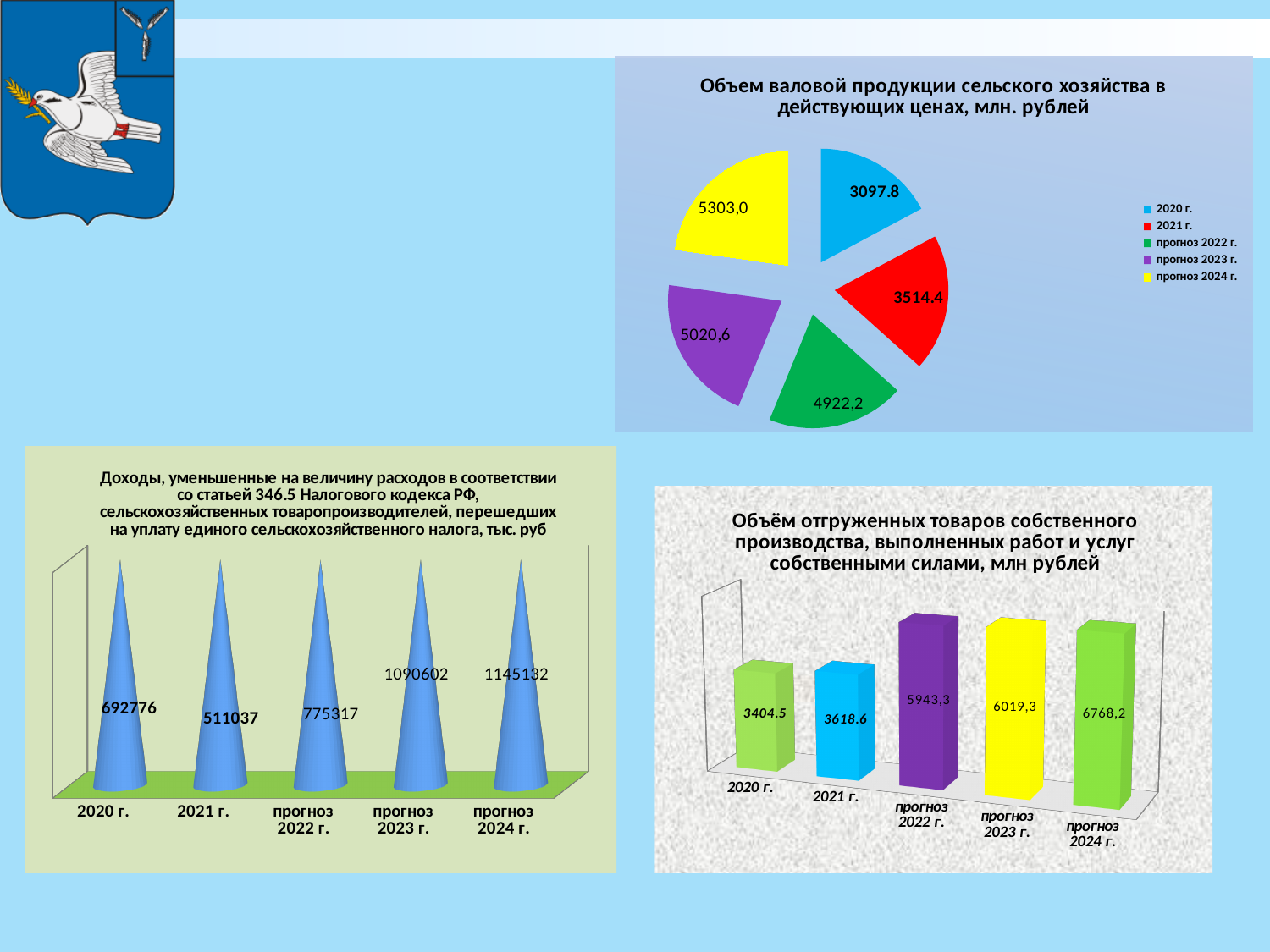
In the pie chart 'Объем валовой продукции сельского хозяйства', what is the difference between the values for 2021 г. and 2020 г.? 416.6 In the bottom-right chart 'Объём отгруженных товаров собственного производства...', which category has the lowest value? 2020 г. In the pie chart 'Объем валовой продукции сельского хозяйства', what colour is the slice for прогноз 2022 г.? Green In the bottom-left chart 'Доходы, уменьшенные на величину расходов...', what is the value for 2021 г.? 511037 In the bottom-left chart 'Доходы, уменьшенные на величину расходов...', which category has the lowest value? 2021 г. In the bottom-left chart 'Доходы, уменьшенные на величину расходов...', how many categories are shown? 5 What kind of chart is the bottom-right chart 'Объём отгруженных товаров собственного производства...'? Bar chart In the bottom-left chart 'Доходы, уменьшенные на величину расходов...', what is the difference between прогноз 2024 г. and прогноз 2023 г.? 54530 In the bottom-right chart 'Объём отгруженных товаров собственного производства...', what is the value for прогноз 2023 г.? 6019,3 In the pie chart 'Объем валовой продукции сельского хозяйства', which year has the largest slice? прогноз 2024 г. In the pie chart 'Объем валовой продукции сельского хозяйства', how many entries does the legend list? 5 In the pie chart 'Объем валовой продукции сельского хозяйства в действующих ценах, млн. рублей', what is the value for 2021 г.? 3514.4